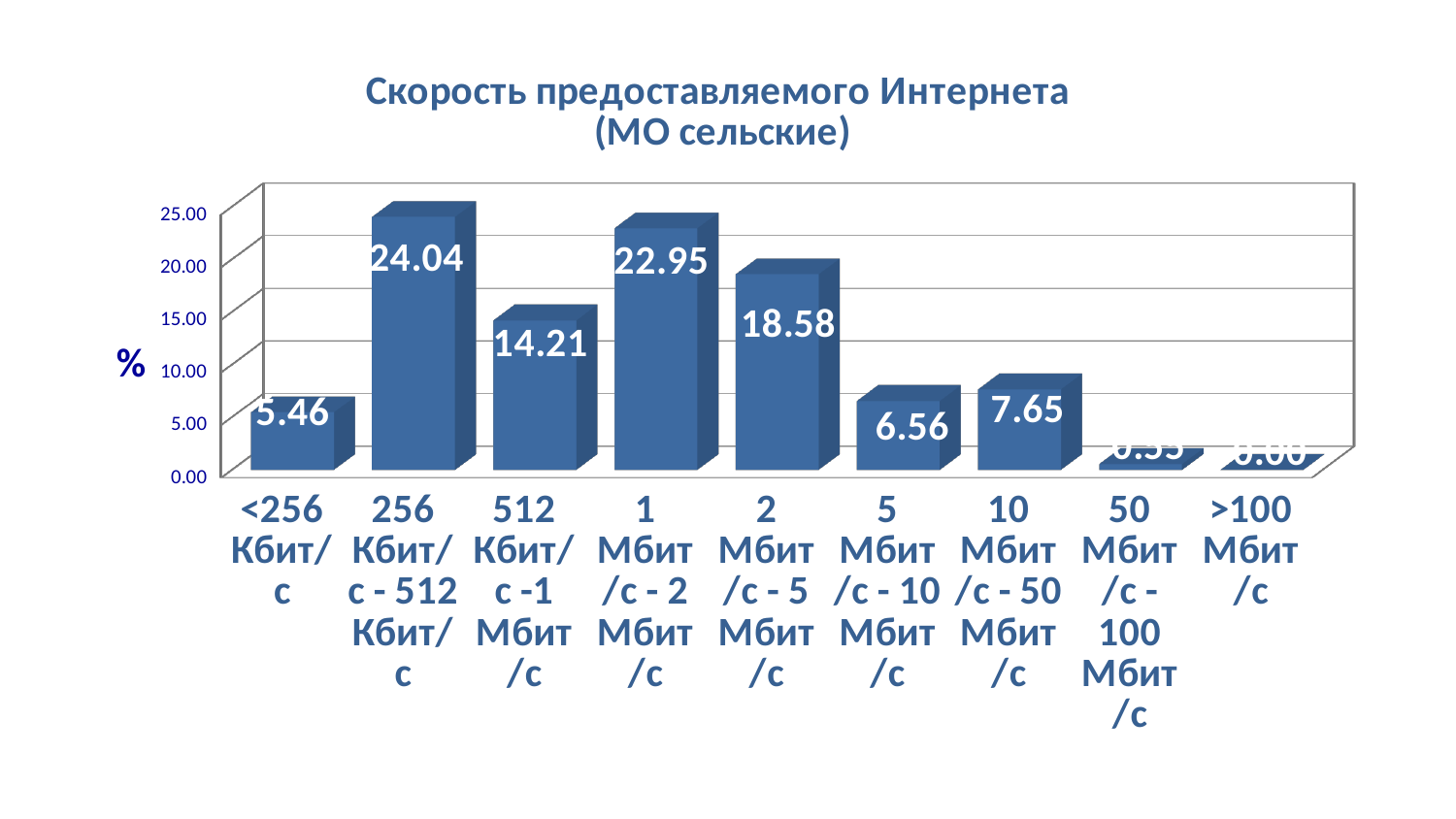
What is the value for the 10 Мбит/с - 50 Мбит/с category? 7.65 What is the difference between the values for 1 Мбит/с - 2 Мбит/с and 512 Кбит/с - 1 Мбит/с? 8.74 What is the title of the chart? Скорость предоставляемого Интернета (МО сельские) How many categories are shown on the x axis? 9 What is the value for the <256 Кбит/с category? 5.46 Is the value for 50 Мбит/с - 100 Мбит/с greater or less than 5.00? less What kind of chart is shown on the slide? bar chart What label is shown on the vertical axis? % Which is larger: the value for 5 Мбит/с - 10 Мбит/с or the value for 10 Мбит/с - 50 Мбит/с? 10 Мбит/с - 50 Мбит/с Which category has the highest value? 256 Кбит/с - 512 Кбит/с What is the value for the 256 Кбит/с - 512 Кбит/с category? 24.04 What is the value for the 2 Мбит/с - 5 Мбит/с category? 18.58